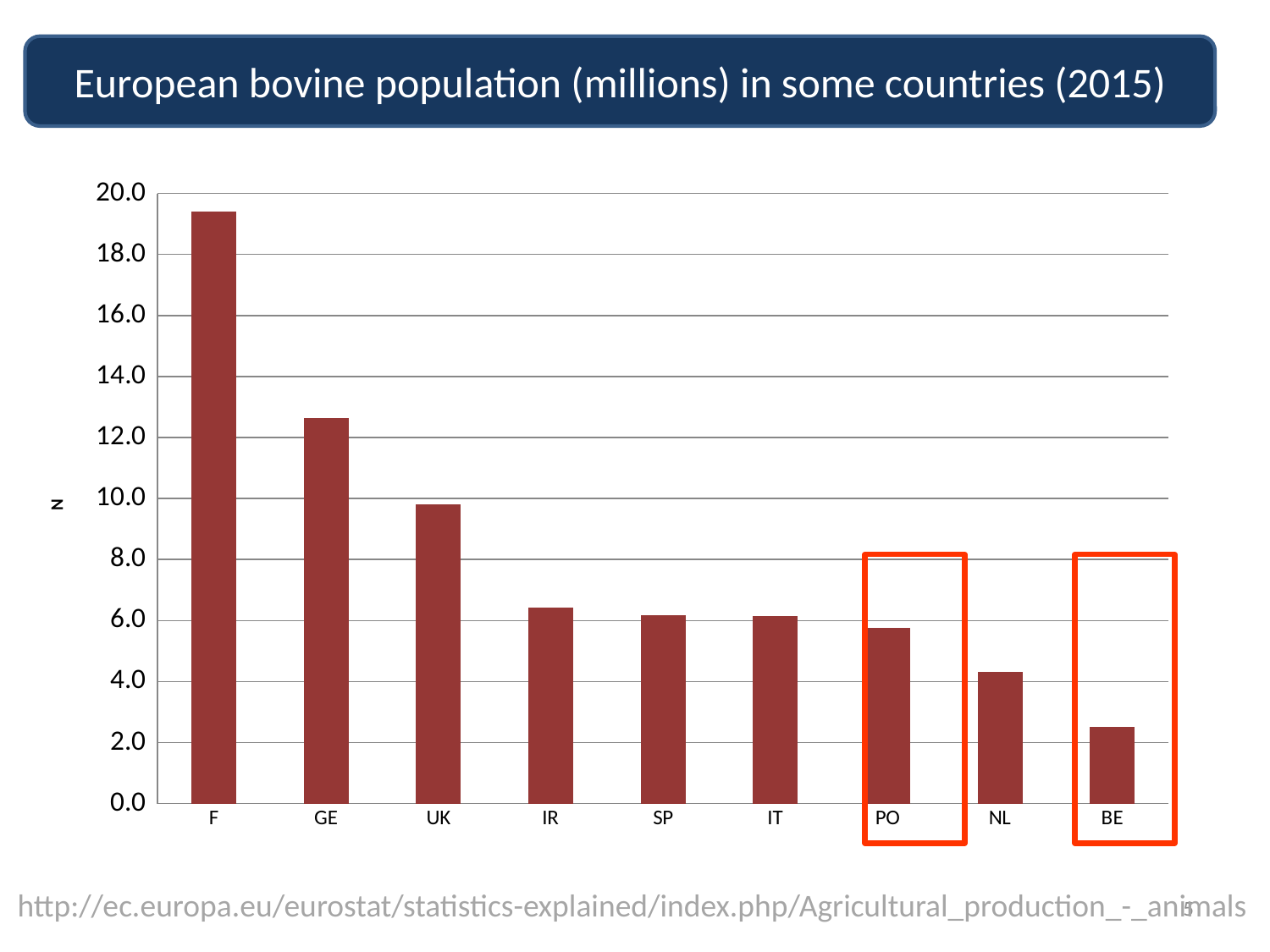
Is the value for UK greater or less than 10.0? less What kind of chart is shown on the slide? bar chart Which has a larger bovine population, GE or UK? GE Is the value for NL greater or less than 4.0? greater Which country has the highest bovine population in the chart? F Which country has the lowest bovine population in the chart? BE Do the values rise or fall moving from left to right along the x axis? fall Is the value for GE greater or less than 12.0? greater How many countries are shown on the x axis of the chart? 9 What is the title of the chart? European bovine population (millions) in some countries (2015)